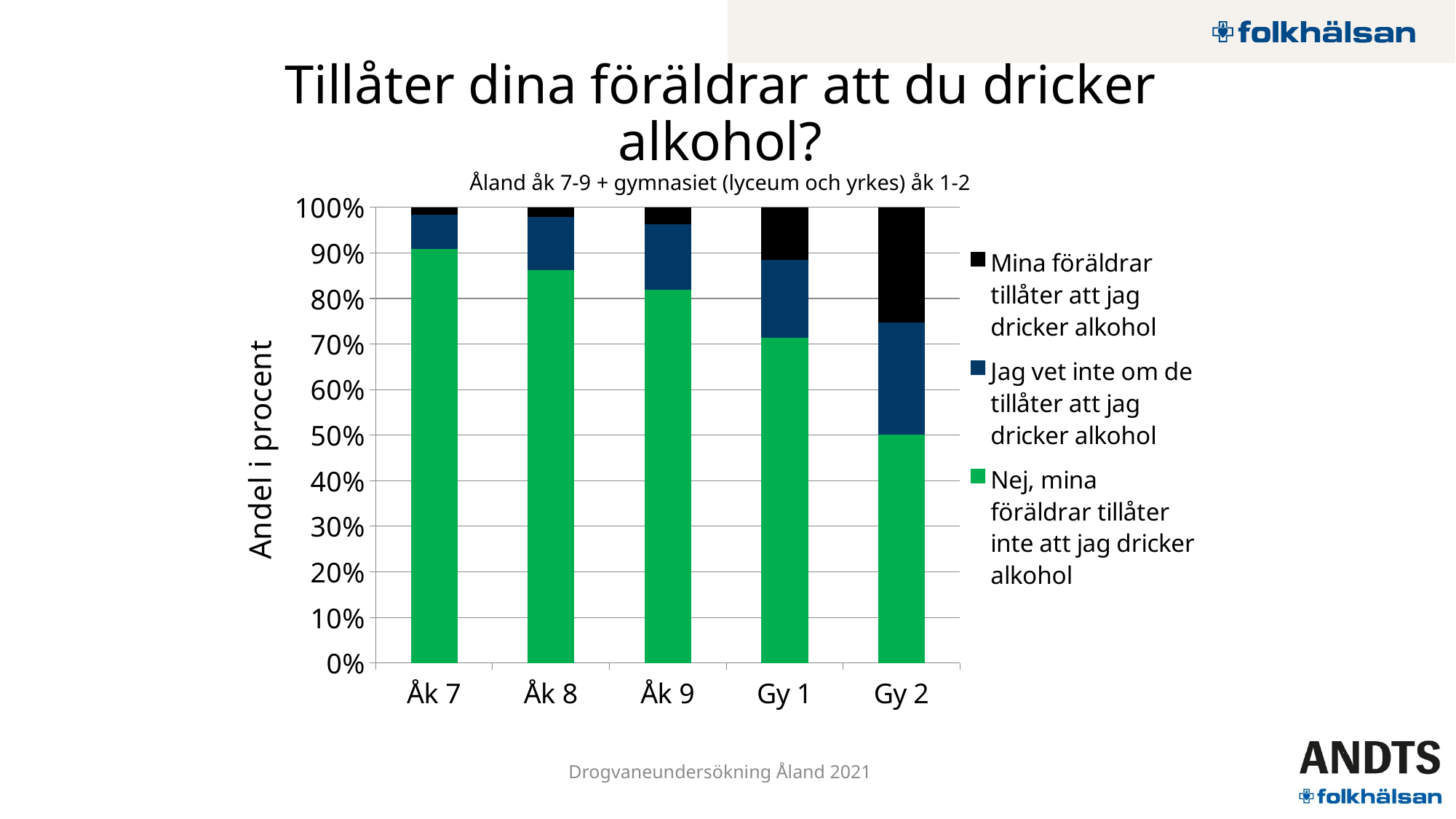
Which is larger: the share for 'Nej, mina föräldrar tillåter inte att jag dricker alkohol' in Åk 8 or in Gy 1? Åk 8 Which category has the largest share for 'Mina föräldrar tillåter att jag dricker alkohol'? Gy 2 Which category has the largest share for 'Nej, mina föräldrar tillåter inte att jag dricker alkohol'? Åk 7 How many series does the legend list? 3 Is the share for 'Nej, mina föräldrar tillåter inte att jag dricker alkohol' in Gy 1 greater or less than 80%? less How many categories (school years) are shown on the x axis? 5 What is the label on the y axis? Andel i procent Which category has the smallest share for 'Nej, mina föräldrar tillåter inte att jag dricker alkohol'? Gy 2 Does the share for 'Nej, mina föräldrar tillåter inte att jag dricker alkohol' rise or fall from Åk 7 to Gy 2? fall What kind of chart is shown on the slide? stacked bar chart What colour represents 'Mina föräldrar tillåter att jag dricker alkohol' in the chart? black